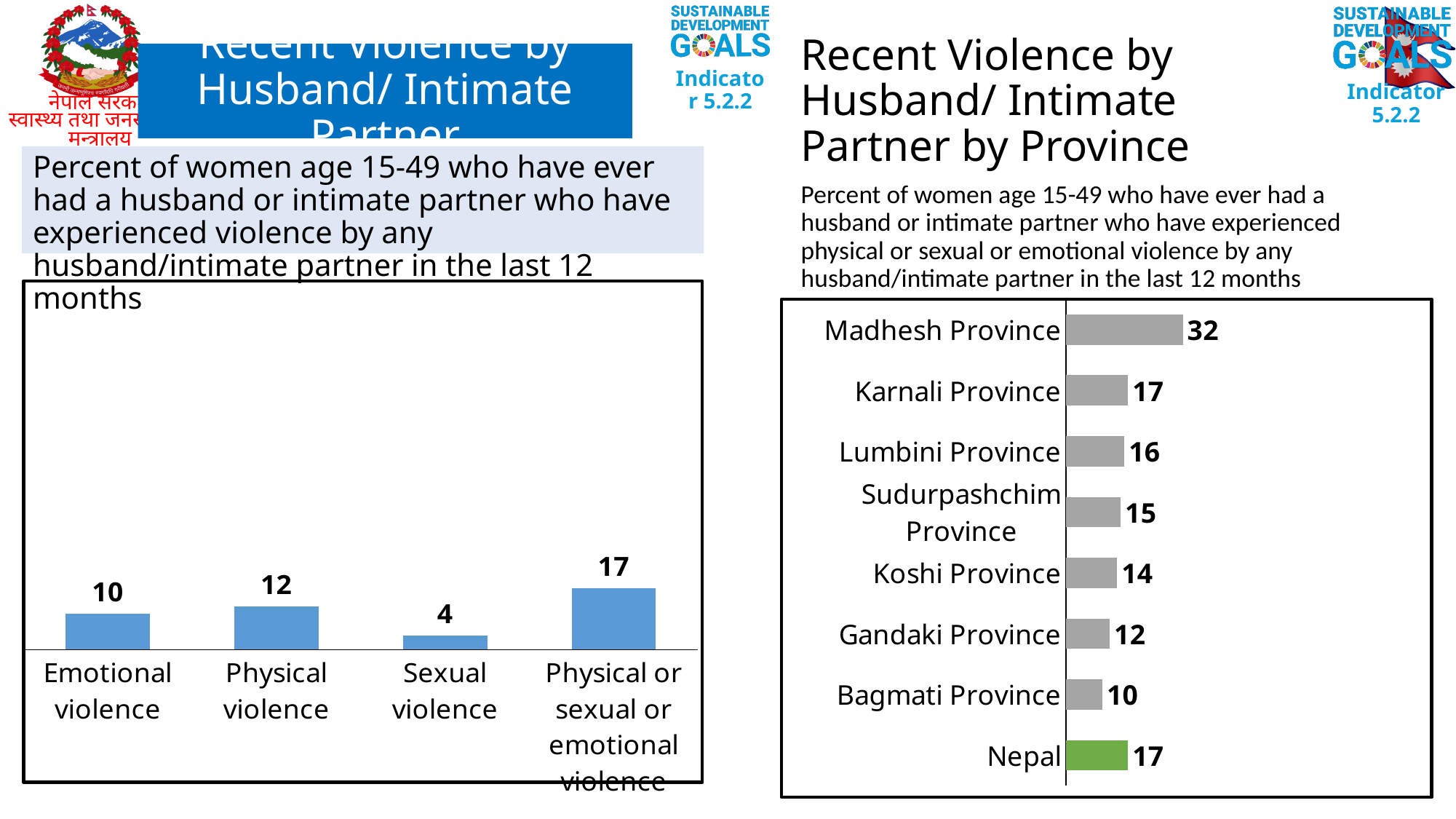
In the right chart (Recent Violence by Husband/Intimate Partner by Province), what is the difference between Madhesh Province and Nepal? 15 In the left chart (Recent Violence by Husband/Intimate Partner), how many categories are shown? 4 In the right chart (Recent Violence by Husband/Intimate Partner by Province), how many bars are shown? 8 In the right chart (Recent Violence by Husband/Intimate Partner by Province), what is the value for Madhesh Province? 32 In the left chart (Recent Violence by Husband/Intimate Partner), what is the difference between Physical violence and Emotional violence? 2 In the right chart (Recent Violence by Husband/Intimate Partner by Province), which province has the lowest value? Bagmati Province In the right chart (Recent Violence by Husband/Intimate Partner by Province), which bar is coloured green? Nepal In the left chart (Recent Violence by Husband/Intimate Partner), what is the value for Sexual violence? 4 In the left chart (Recent Violence by Husband/Intimate Partner), which category has the highest value? Physical or sexual or emotional violence In the left chart (Recent Violence by Husband/Intimate Partner), which category has the lowest value? Sexual violence What kind of chart is the left chart (Recent Violence by Husband/Intimate Partner)? Bar chart In the right chart (Recent Violence by Husband/Intimate Partner by Province), which is larger, Karnali Province or Gandaki Province? Karnali Province